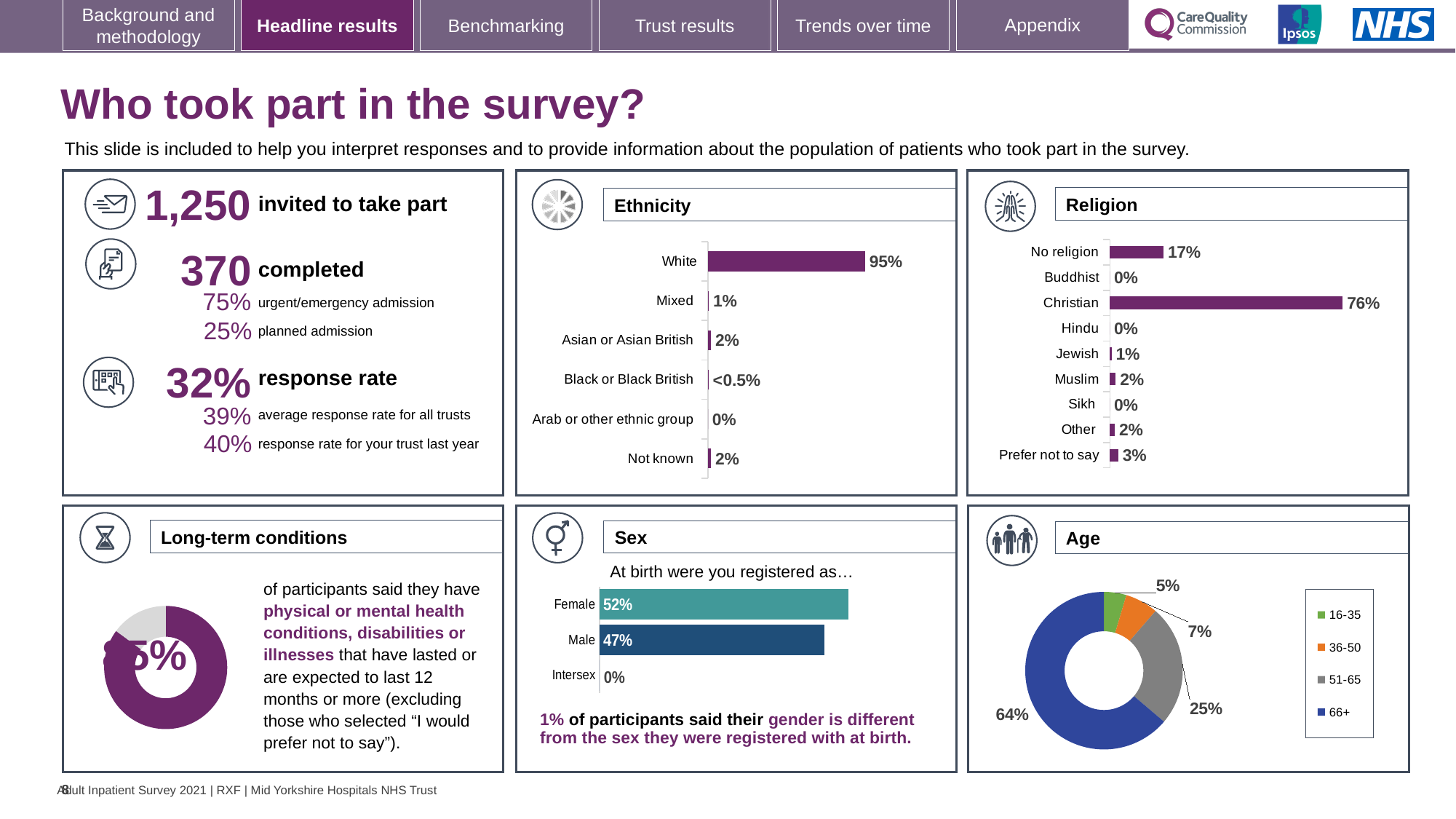
In the Religion chart, what percentage of participants said they had no religion? 17% In the Religion chart, which religion category has the highest value? Christian In the Religion chart, what is the difference between the Christian and No religion values? 59% In the Age chart, how many age groups does the legend list? 4 In the Ethnicity chart, what is the value for Black or Black British? <0.5% In the Age chart, what share of participants were aged 66+? 64% In the Sex chart, what percentage of participants were registered as Female at birth? 52% In the Sex chart, which is larger, the Female value or the Male value? Female In the Ethnicity chart, how many ethnic group categories are shown? 6 In the Religion chart, what is the value for Prefer not to say? 3% In the Ethnicity chart, what percentage of participants were White? 95% What kind of chart is the Age chart? Doughnut chart